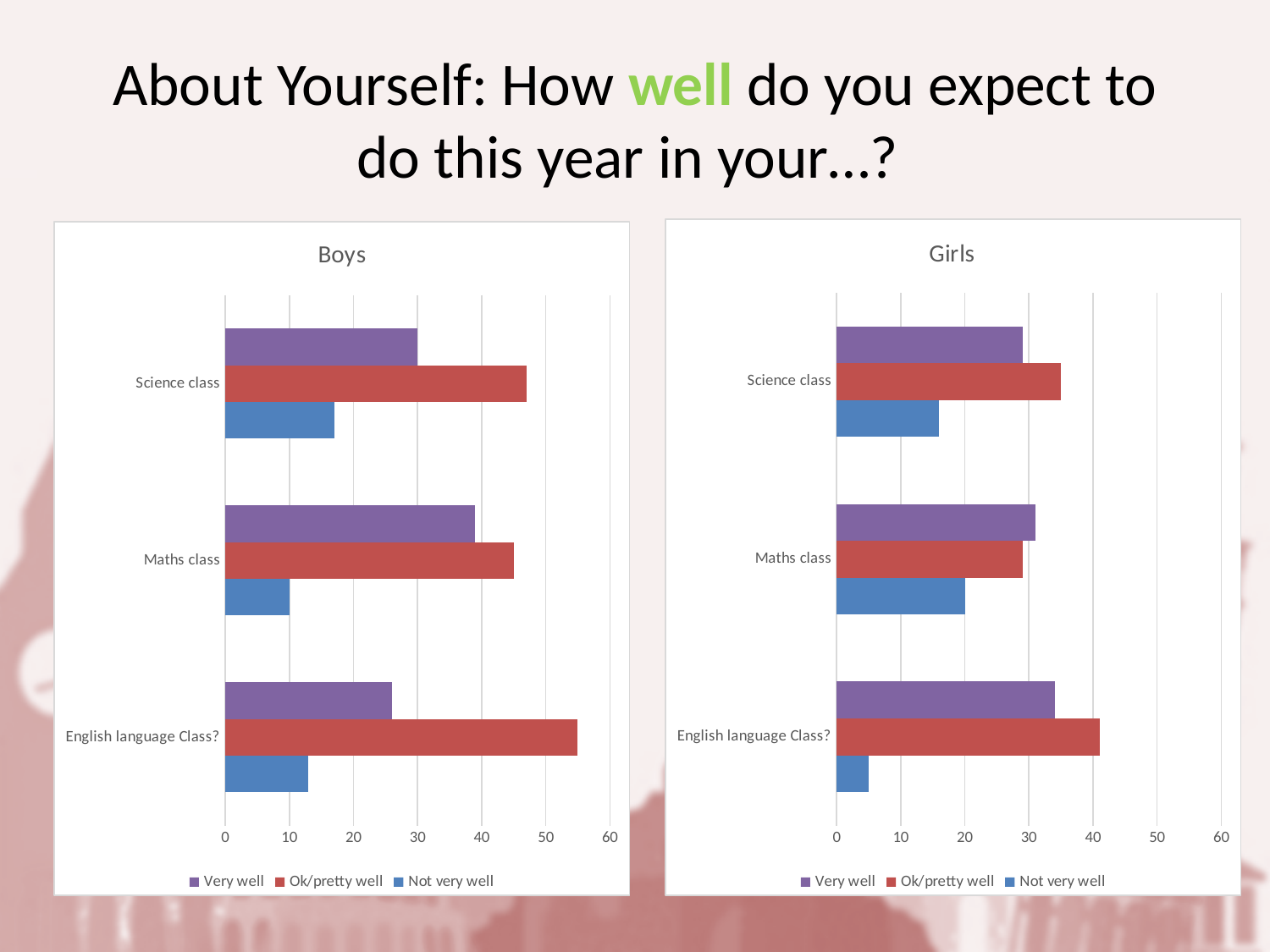
What are the three legend entries on the Boys chart? Very well, Ok/pretty well, Not very well What kind of chart is the Boys chart? bar chart On the Girls chart, which category has the highest 'Very well' value? English language Class? On the Girls chart, is the 'Not very well' value for English language Class? greater or less than 10? less On the Boys chart, what is the 'Not very well' value for Maths class? 10 On the Boys chart, is the 'Not very well' value for Science class greater or less than 20? less On the Girls chart, which category has the lowest 'Not very well' value? English language Class? How many categories are shown on the Boys chart? 3 On the Girls chart, for English language Class?, which is larger: 'Very well' or 'Ok/pretty well'? Ok/pretty well How many series does the legend of the Girls chart list? 3 On the Boys chart, is the 'Ok/pretty well' value for English language Class? greater or less than 50? greater On the Boys chart, which category has the highest 'Ok/pretty well' value? English language Class?